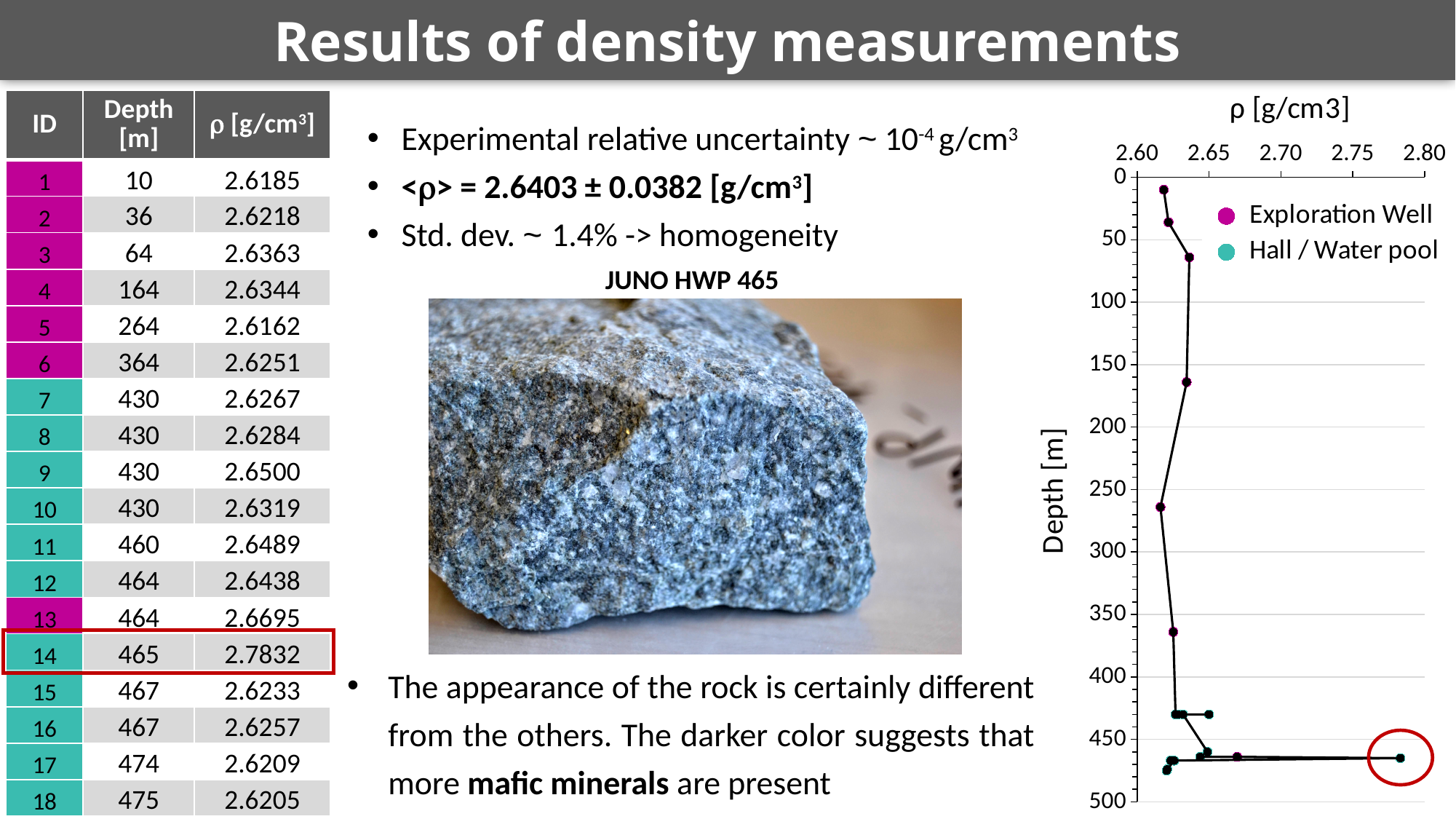
In the density chart, is the density value at depth 264 m greater or less than 2.65? less In the density chart, is the density value at depth 10 m greater or less than 2.65? less What kind of chart is shown on the right of the slide? scatter plot In the density chart, which has the larger density: the point at depth 164 m or the point at depth 264 m? 164 m What is the title of the vertical axis of the density chart? Depth [m] What are the two legend entries of the density chart? Exploration Well; Hall / Water pool In the density chart, at which depth is the highest density value plotted? 465 m How many series does the legend of the density chart list? 2 In the density chart, is the circled point near depth 465 m greater or less than 2.75? greater In the density chart, which has the larger density: the point at depth 64 m or the point at depth 10 m? 64 m